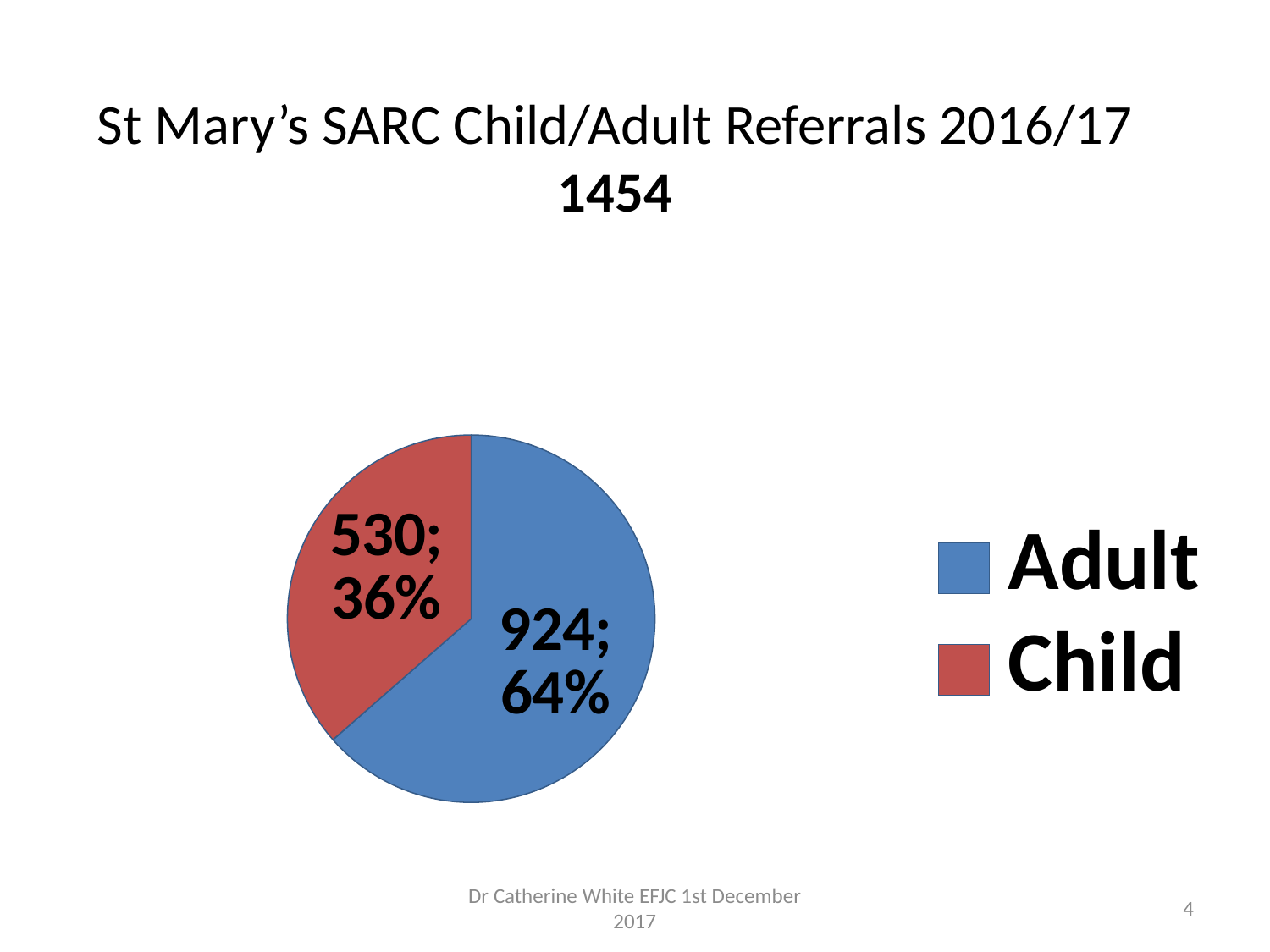
How many entries does the legend list? 2 What percentage of the pie does the Adult slice represent? 64% What percentage of the pie does the Child slice represent? 36% What colour is the Child slice in the pie chart? red Which category has the smallest slice of the pie? Child How many referrals are shown for Child? 530 Which category has the larger slice, Adult or Child? Adult What is the total number of referrals shown across both slices? 1454 How many referrals are shown for Adult? 924 What is the difference between the Adult and Child referral counts? 394 How many slices does the pie chart have? 2 What kind of chart is shown on the slide? pie chart